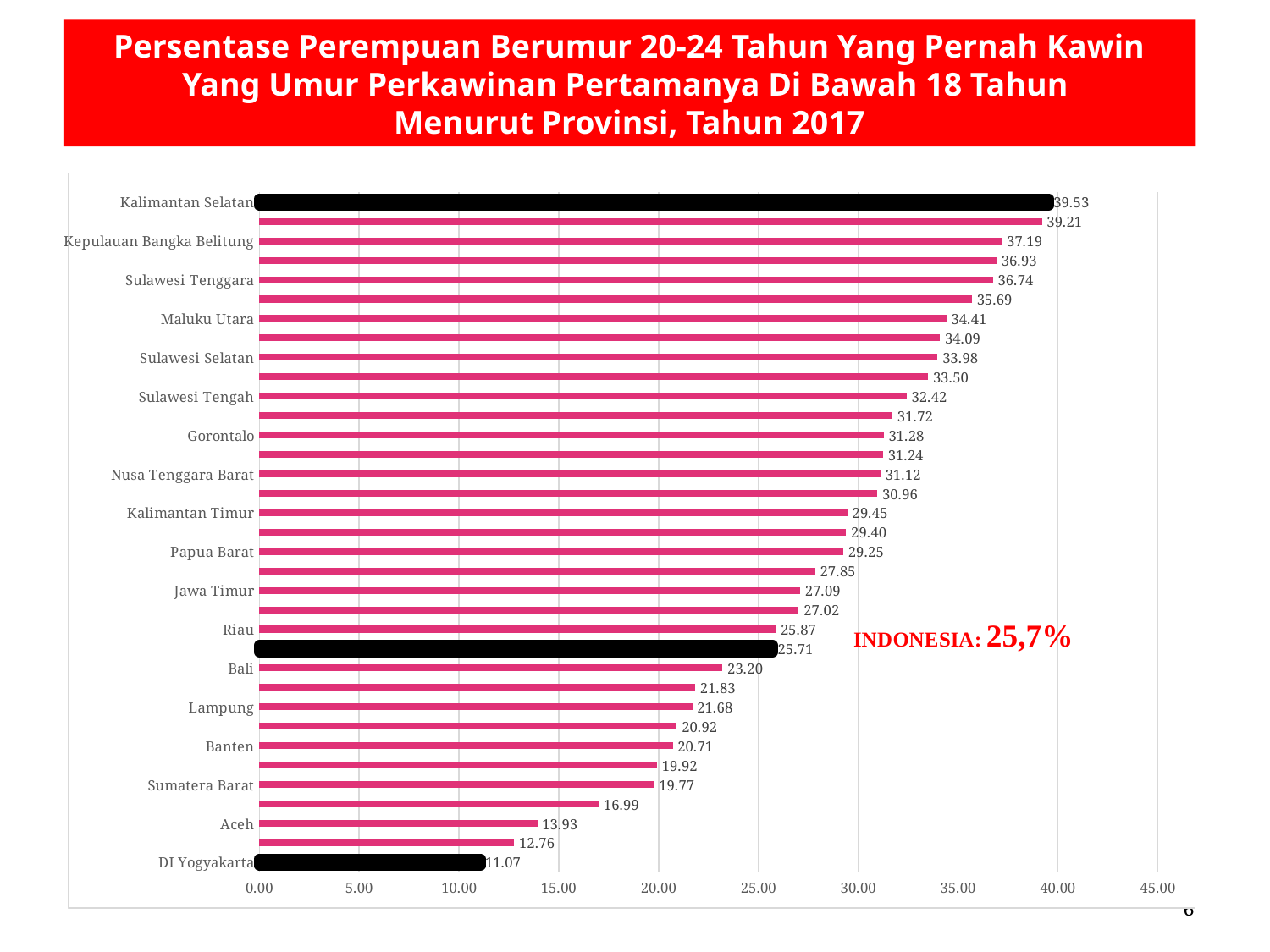
What national figure for Indonesia is annotated on the chart? 25,7% Which has a larger value, Bali or Aceh? Bali What is the value for Aceh? 13.93 Is the value for Lampung greater or less than 25.00? less What is the value for DI Yogyakarta? 11.07 What is the value for Kalimantan Selatan? 39.53 What kind of chart is shown on the slide? bar chart How many bars are plotted in the chart? 35 Which province has the highest value? Kalimantan Selatan What is the difference between the values for Kalimantan Selatan and DI Yogyakarta? 28.46 Which province has the lowest value? DI Yogyakarta What is the value for Jawa Timur? 27.09